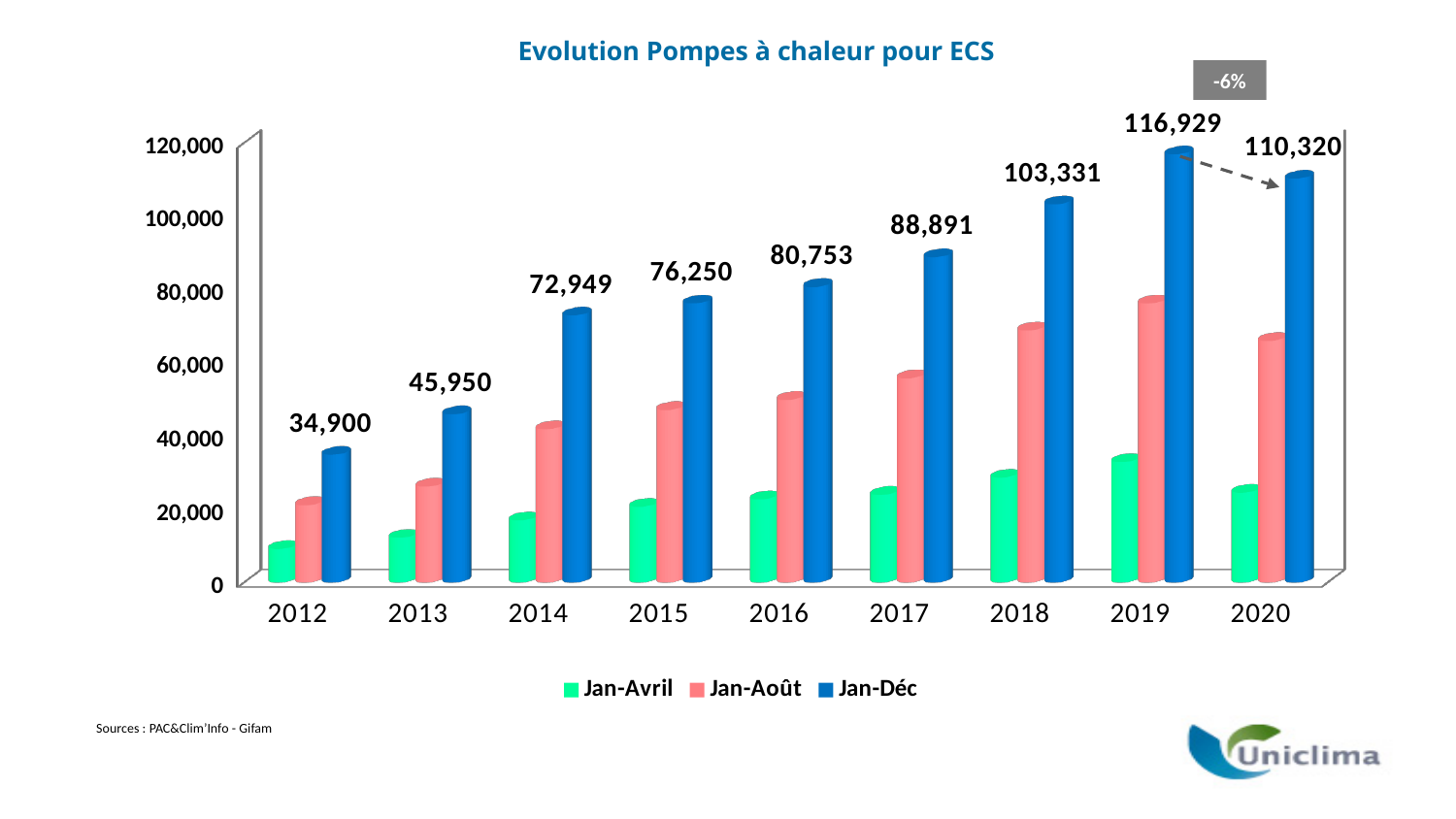
Which is larger, the Jan-Déc value for 2017 or for 2018? 2018 What is the difference between the Jan-Déc values for 2019 and 2020? 6,609 Which year has the lowest Jan-Déc value? 2012 What is the Jan-Déc value for 2019? 116,929 What is the Jan-Déc value for 2016? 80,753 Is the Jan-Avril value for 2019 greater or less than 40,000? less Is the Jan-Août value for 2019 greater or less than 60,000? greater How many series does the legend list? 3 How many years are shown on the x axis? 9 What is the Jan-Déc value for 2012? 34,900 What kind of chart is shown on the slide? Bar chart Which year has the highest Jan-Déc value? 2019